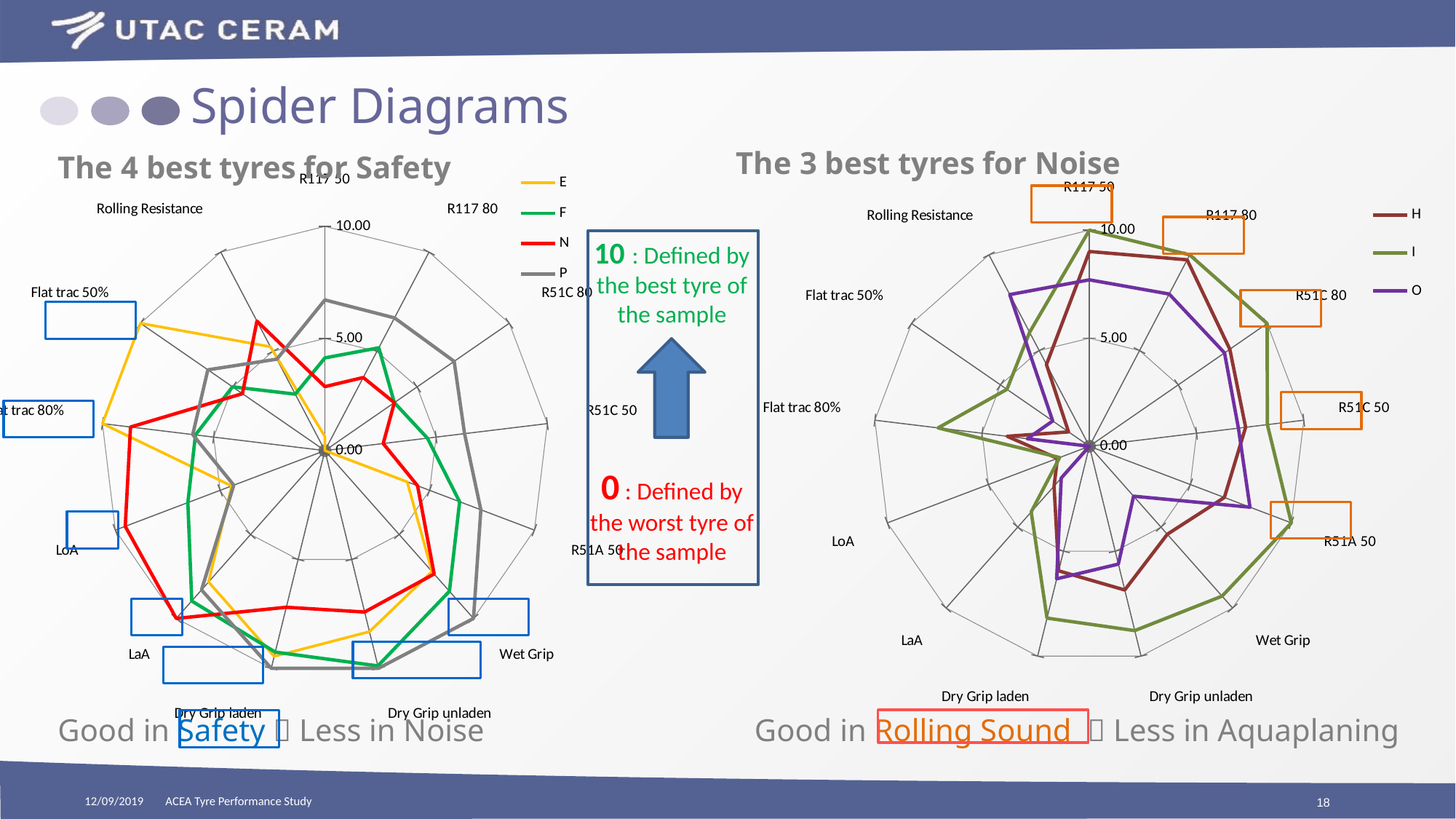
How many series does the legend of 'The 4 best tyres for Safety' list? 4 In 'The 3 best tyres for Noise', is the value of series O at R51C 50 greater or less than 5.00? greater In 'The 3 best tyres for Noise', which series are listed in the legend? H, I, O In 'The 4 best tyres for Safety', is the value of series E at Flat trac 50% greater or less than 5.00? greater In 'The 4 best tyres for Safety', is the value of series P at Wet Grip greater or less than 5.00? greater In 'The 4 best tyres for Safety', which series has the larger value at Wet Grip, P or N? P How many series does the legend of 'The 3 best tyres for Noise' list? 3 In 'The 4 best tyres for Safety', which series are listed in the legend? E, F, N, P In 'The 3 best tyres for Noise', which series has the highest value at Rolling Resistance? O What kind of chart is 'The 4 best tyres for Safety'? Radar chart